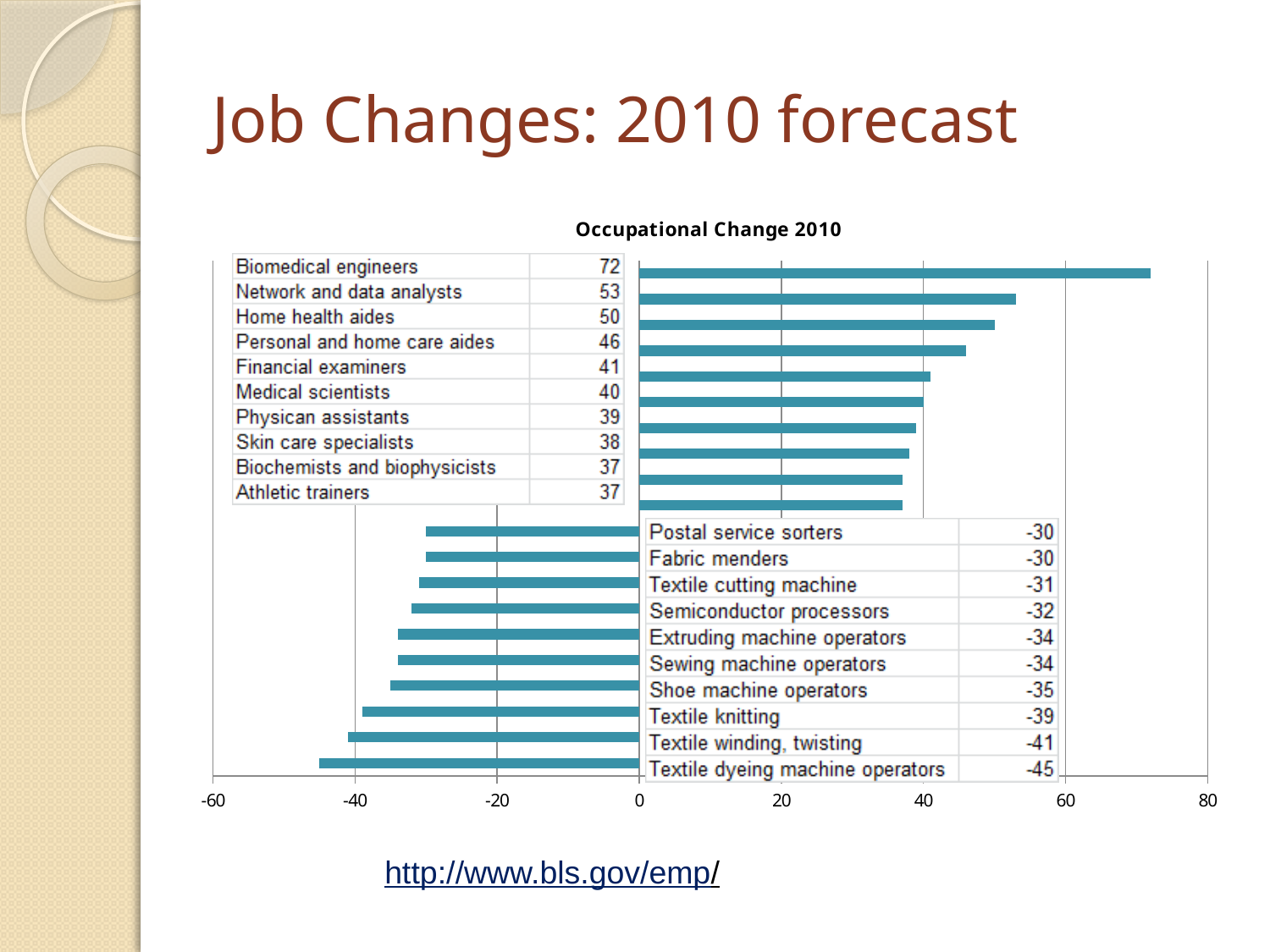
What is the value for Home health aides? 50 Which occupation has the lowest value? Textile dyeing machine operators What is the value for Biomedical engineers? 72 How many occupations are plotted in the chart? 20 Which occupation has the highest value? Biomedical engineers What is the value for Textile dyeing machine operators? -45 What kind of chart is shown on the slide? bar chart Which is larger, the value for Financial examiners or the value for Medical scientists? Financial examiners What is the difference between the values for Biomedical engineers and Network and data analysts? 19 What is the title of the chart? Occupational Change 2010 What is the value for Semiconductor processors? -32 What is the difference between the values for Textile knitting and Textile winding, twisting? 2